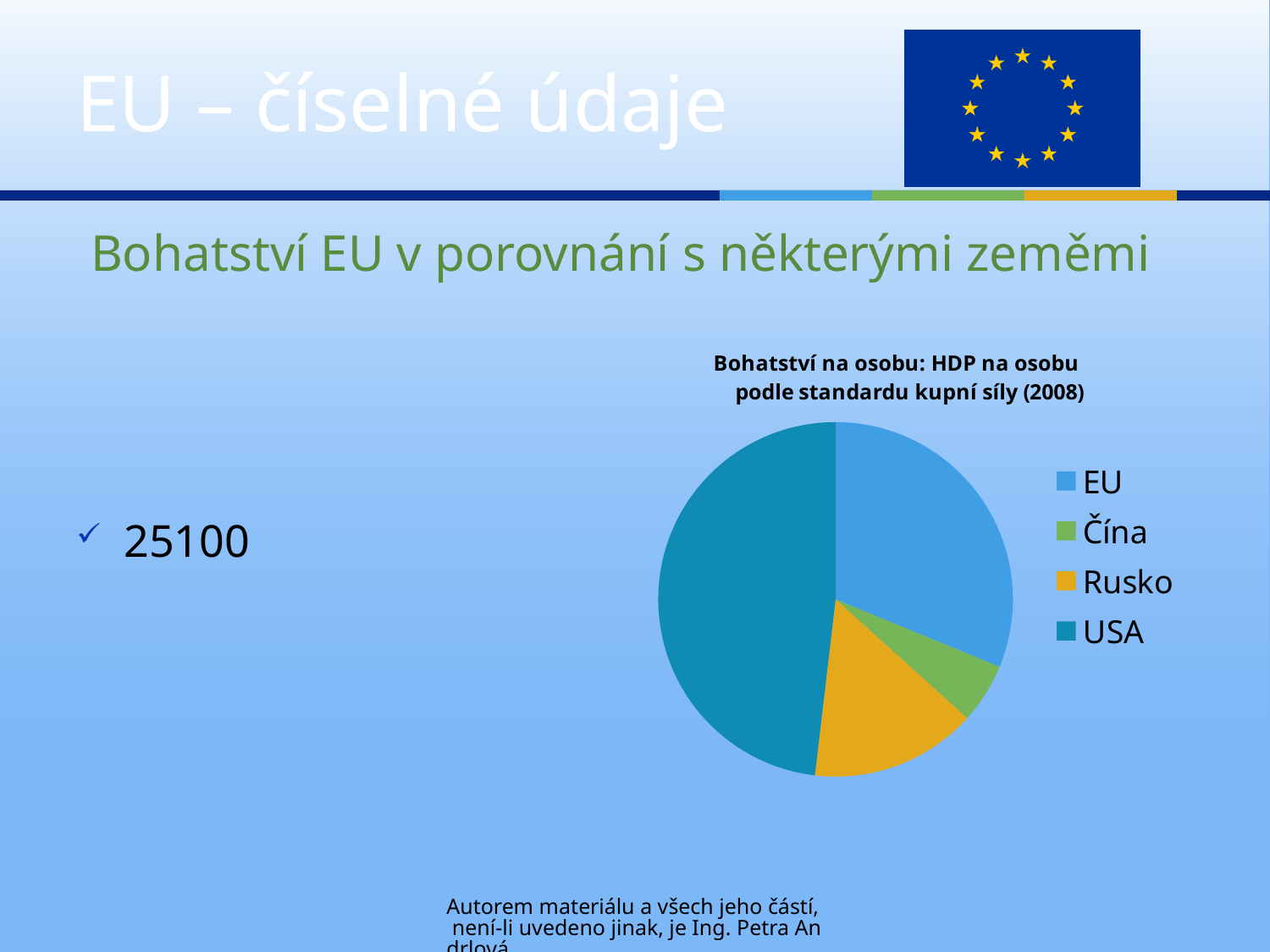
Which category has the largest slice in the pie chart? USA Which category has the smallest slice in the pie chart? Čína Which slice is larger in the pie chart, USA or EU? USA Which slice is larger in the pie chart, Rusko or Čína? Rusko Which slice is larger in the pie chart, EU or Rusko? EU How many categories does the pie chart show? 4 What is the title of the pie chart? Bohatství na osobu: HDP na osobu podle standardu kupní síly (2008) Which category is shown in green in the pie chart? Čína What kind of chart is shown on the slide? pie chart